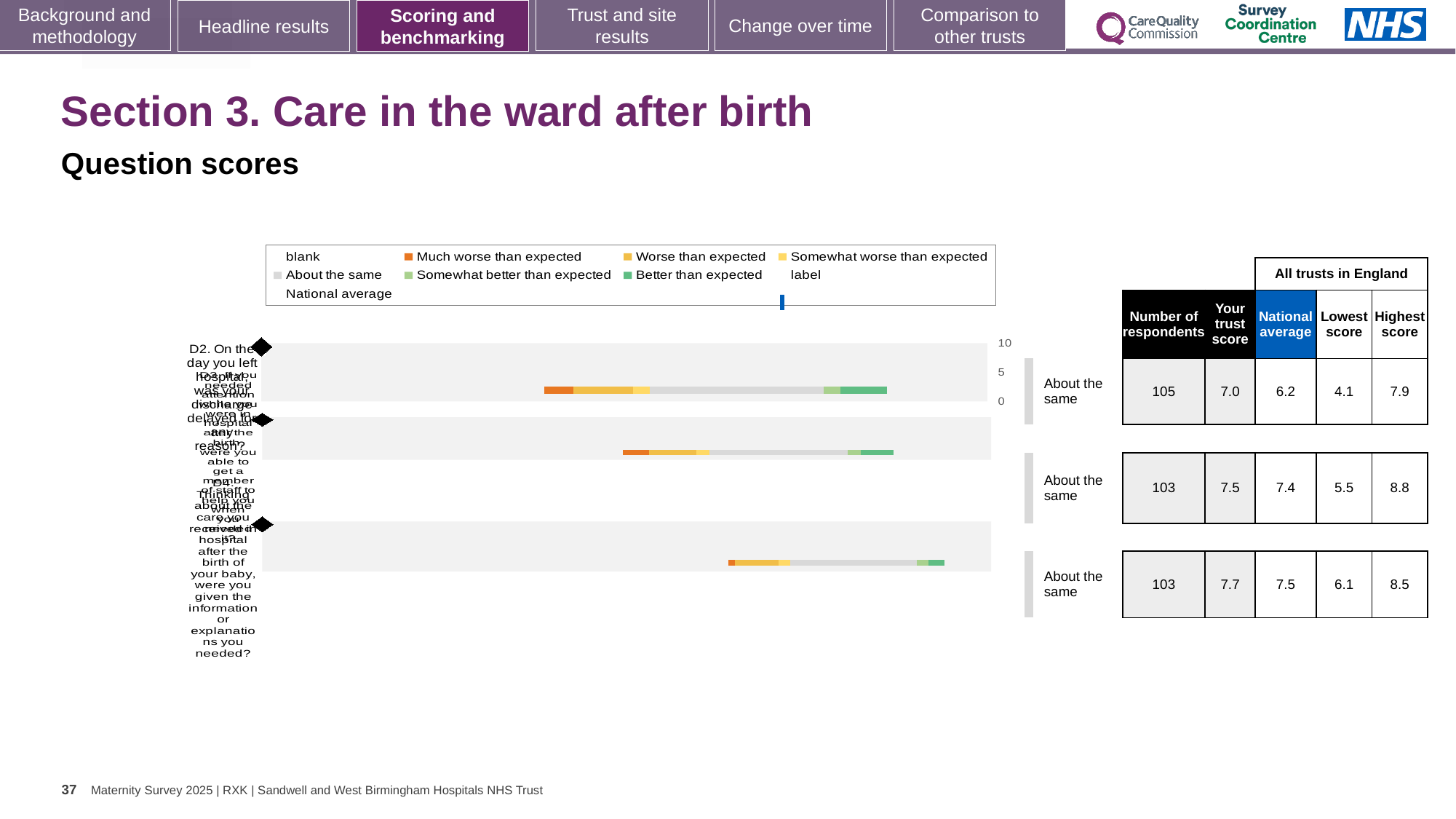
How many bars (question rows) are plotted in the chart? 3 In the chart legend, which category is shown in dark orange? Much worse than expected In the table beside the chart, what is the lowest score for the first row? 4.1 In the table beside the chart, what is the highest score for the second row? 8.8 In the table beside the chart, what is the 'Your trust score' for the second row? 7.5 What kind of chart is shown on the slide? bar chart In the table beside the chart, which row has the highest 'Your trust score'? the third row (7.7) In the table beside the chart, what is the national average for the third row? 7.5 In the table beside the chart, is 'Your trust score' or the national average larger for the second row? Your trust score (7.5) In the table beside the chart, what is the difference between 'Your trust score' and the national average for the first row? 0.8 What is the highest value shown on the chart's axis? 10 In the table beside the chart, what is the number of respondents for the first row? 105